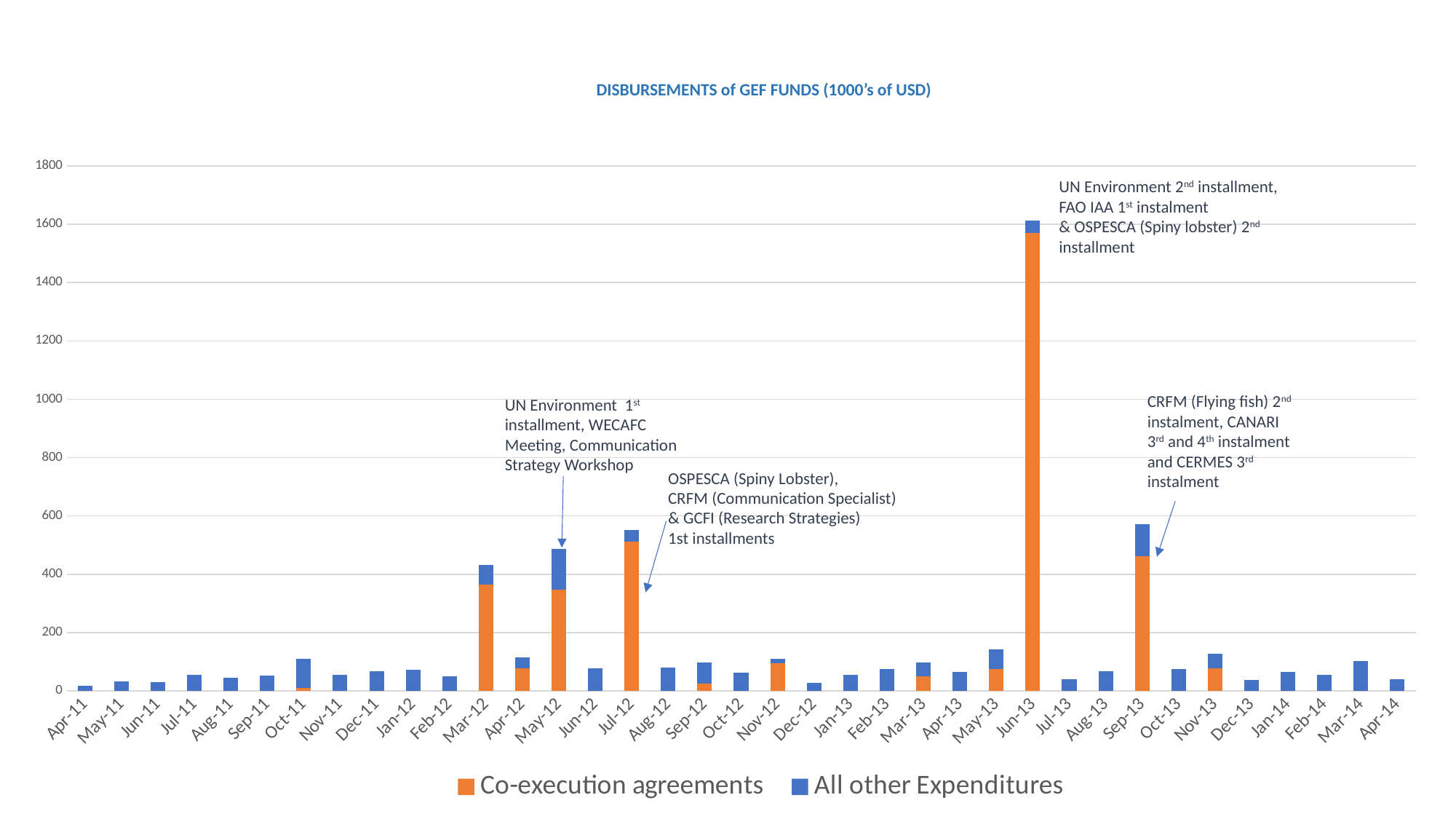
Is the total value for Jul-12 greater or less than 400? greater Which month has the highest total disbursement? Jun-13 What kind of chart is shown on the slide? Stacked bar chart Which has the larger total disbursement, Jul-12 or Mar-12? Jul-12 Is the total value for Sep-13 greater or less than 400? greater Which series is shown in orange? Co-execution agreements How many series does the legend list? 2 How many months are shown on the x axis? 37 What is the title of the chart? DISBURSEMENTS of GEF FUNDS (1000's of USD) Is the total value for Jun-13 greater or less than 1400? greater Which has the larger total disbursement, Jun-13 or Sep-13? Jun-13